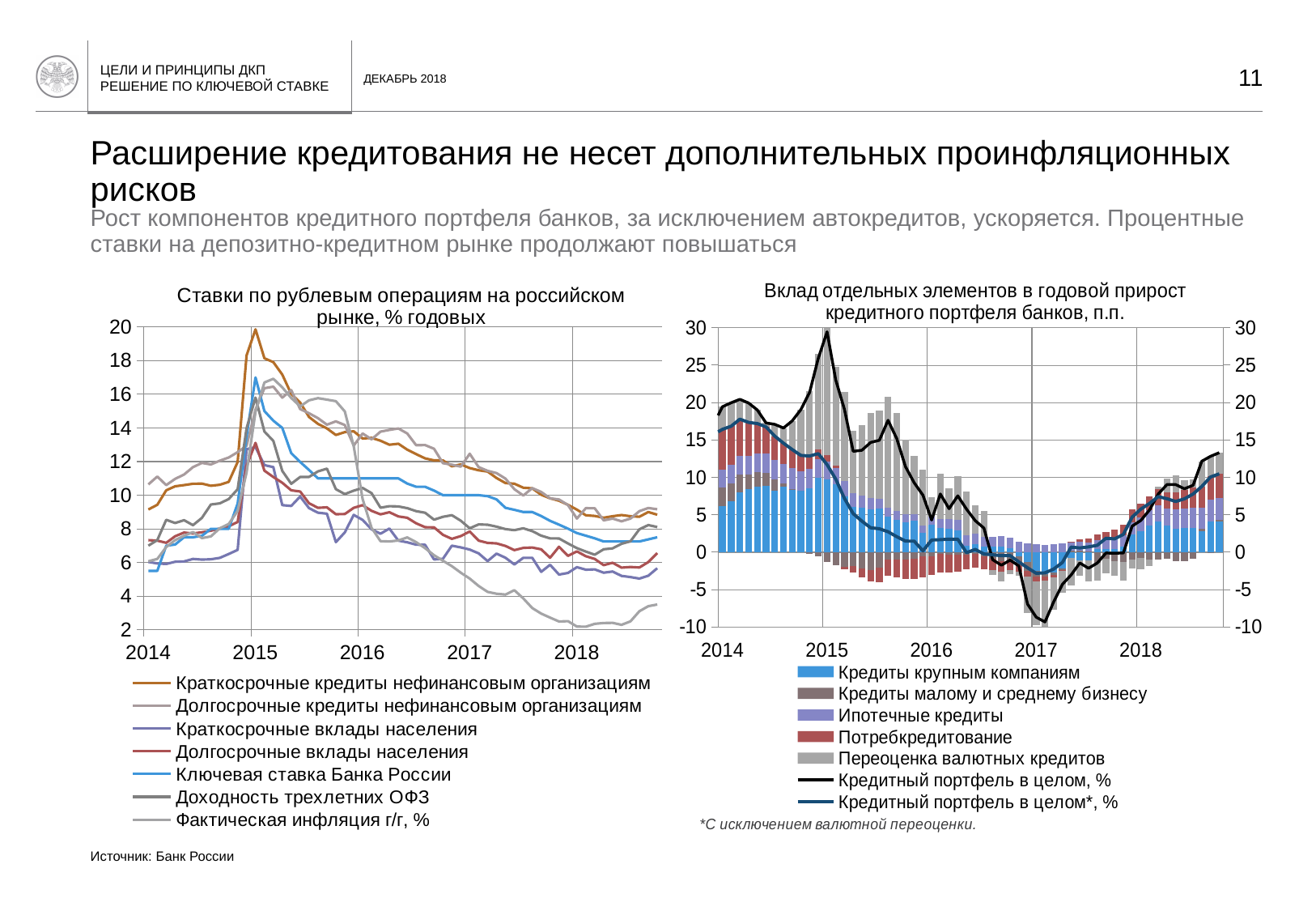
In the left chart, does 'Ключевая ставка Банка России' rise or fall from early 2015 to 2018? fall In the left chart, which series falls to the lowest value over the whole period? Фактическая инфляция г/г, % In the left chart, is the value of 'Фактическая инфляция г/г, %' at the start of 2018 greater or less than 4? less In the right chart, does 'Кредитный портфель в целом, %' rise or fall from early 2017 to the end of 2018? rise In the left chart, is the peak value of 'Ключевая ставка Банка России' in early 2015 greater or less than 16? greater How many entries does the legend of the right chart list? 7 What kind of chart is the left chart, 'Ставки по рублевым операциям на российском рынке, % годовых'? line chart In the right chart, is the peak value of 'Кредитный портфель в целом, %' in early 2015 greater or less than 25? greater In the left chart, which series reaches the highest value over the whole period? Краткосрочные кредиты нефинансовым организациям What kind of chart is the right chart, 'Вклад отдельных элементов в годовой прирост кредитного портфеля банков, п.п.'? stacked bar chart with line series How many series does the legend of the left chart list? 7